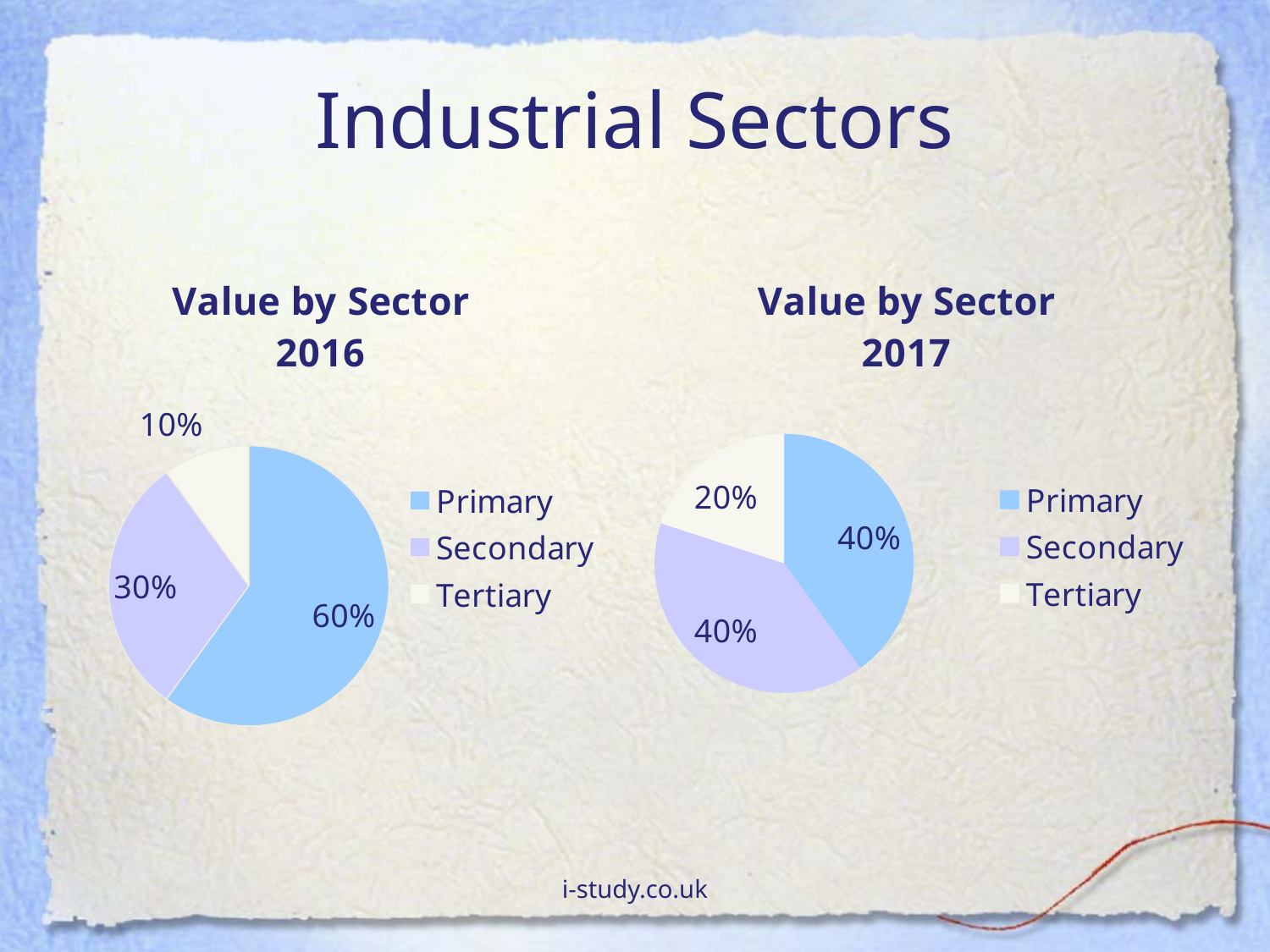
How many categories does the legend of the 'Value by Sector 2016' chart list? 3 In the 'Value by Sector 2016' chart, which is larger, Secondary or Tertiary? Secondary In the 'Value by Sector 2017' chart, what share does Tertiary have? 20% In the 'Value by Sector 2017' chart, which sector has the smallest share? Tertiary In the 'Value by Sector 2016' chart, which sector has the largest share? Primary In the 'Value by Sector 2016' chart, what share does Tertiary have? 10% What kind of chart is the 'Value by Sector 2017' chart? Pie chart In the 'Value by Sector 2016' chart, what is the difference between the Primary and Secondary shares? 30% In the 'Value by Sector 2017' chart, what share does Primary have? 40% In the 'Value by Sector 2016' chart, which sector has the smallest share? Tertiary In the 'Value by Sector 2016' chart, what share does Secondary have? 30% In the 'Value by Sector 2016' chart, what share does Primary have? 60%